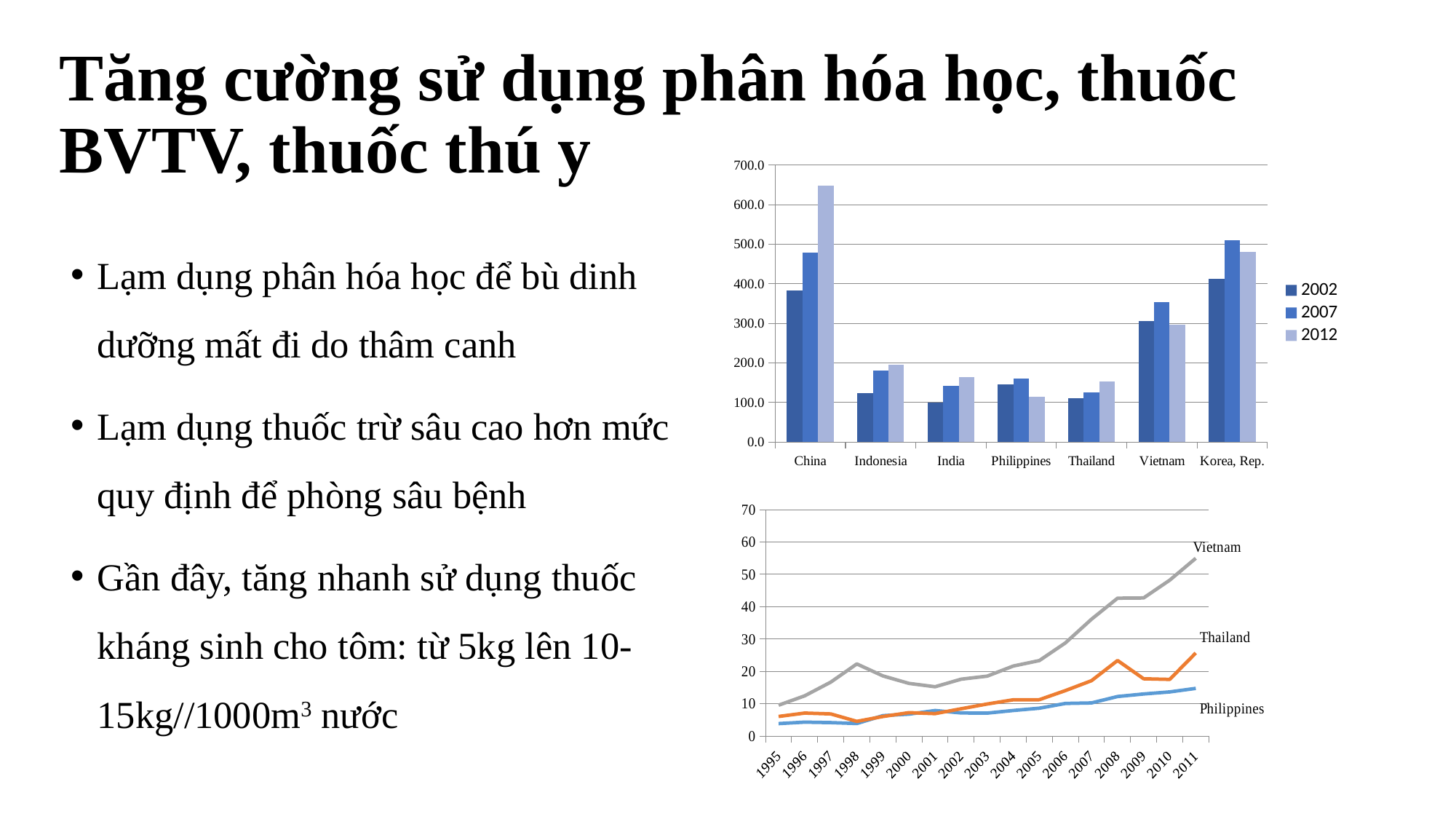
In the upper bar chart, is the 2012 value for China greater or less than 600? greater What kind of chart is the upper chart on the slide? bar chart In the upper bar chart, how many countries are shown on the x axis? 7 What kind of chart is the lower chart on the slide? line chart In the upper bar chart, which country has the highest 2012 value? China In the lower line chart, is the value for Vietnam in 2011 greater or less than 50? greater In the lower line chart, how many years are shown on the x axis? 17 In the upper bar chart, is the 2002 value for Indonesia greater or less than 200? less In the lower line chart, which country has the highest value in 2011? Vietnam In the upper bar chart, how many series does the legend list? 3 In the upper bar chart, which is larger for 2007: Vietnam or Korea, Rep.? Korea, Rep. In the upper bar chart, which country has the lowest 2012 value? Philippines